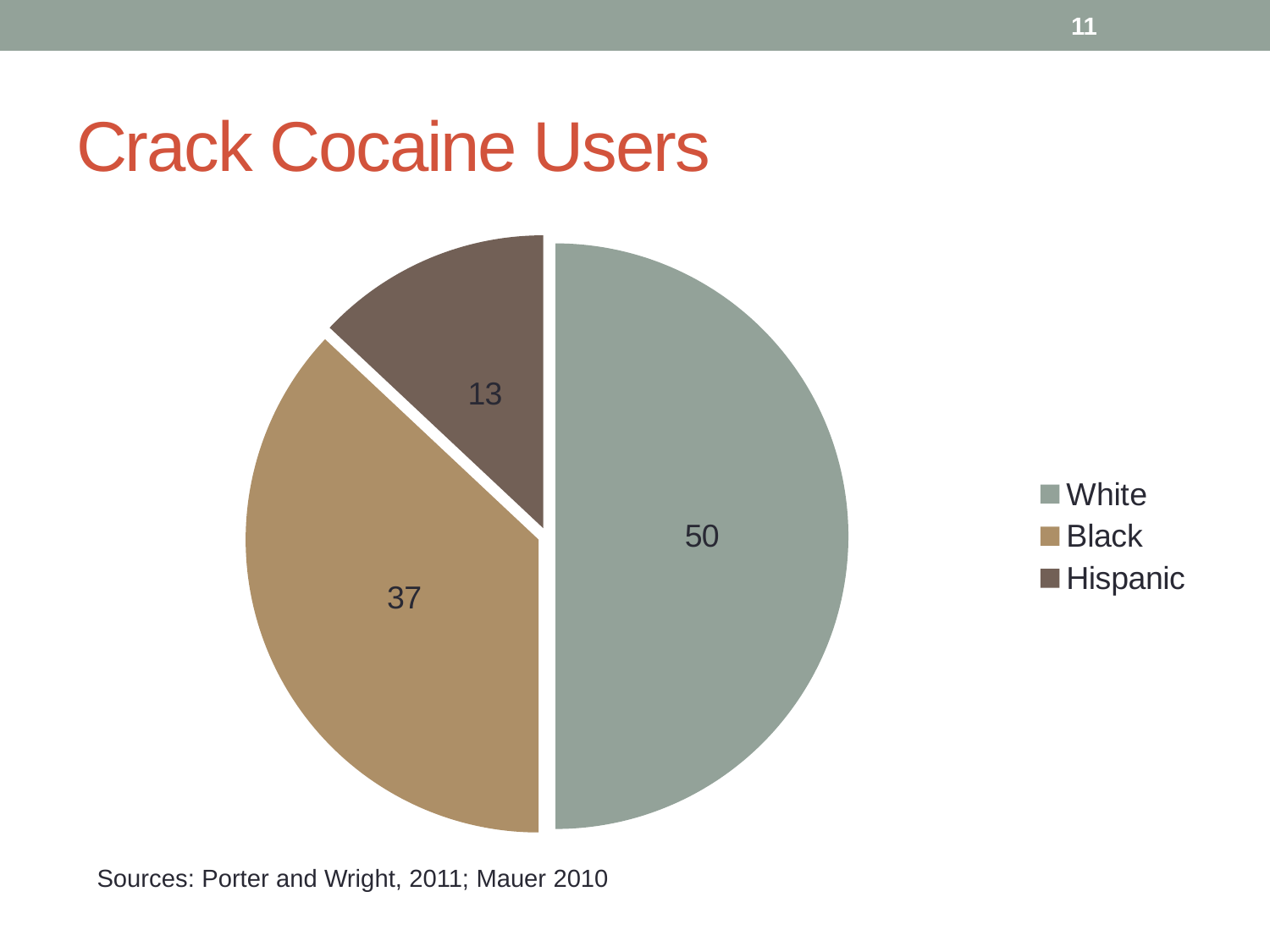
What is the title of the chart on the slide? Crack Cocaine Users What is the difference between the values for Black and Hispanic in the Crack Cocaine Users pie chart? 24 What is the value for Hispanic in the Crack Cocaine Users pie chart? 13 Which category has the largest slice in the Crack Cocaine Users pie chart? White Which category has the smallest slice in the Crack Cocaine Users pie chart? Hispanic What is the difference between the values for White and Black in the Crack Cocaine Users pie chart? 13 How many categories are shown in the Crack Cocaine Users pie chart? 3 What is the value for Black in the Crack Cocaine Users pie chart? 37 What is the value for White in the Crack Cocaine Users pie chart? 50 What is the total of the three values shown in the Crack Cocaine Users pie chart? 100 What kind of chart is shown on the slide? Pie chart Which is larger in the Crack Cocaine Users pie chart, the value for Black or the value for Hispanic? Black